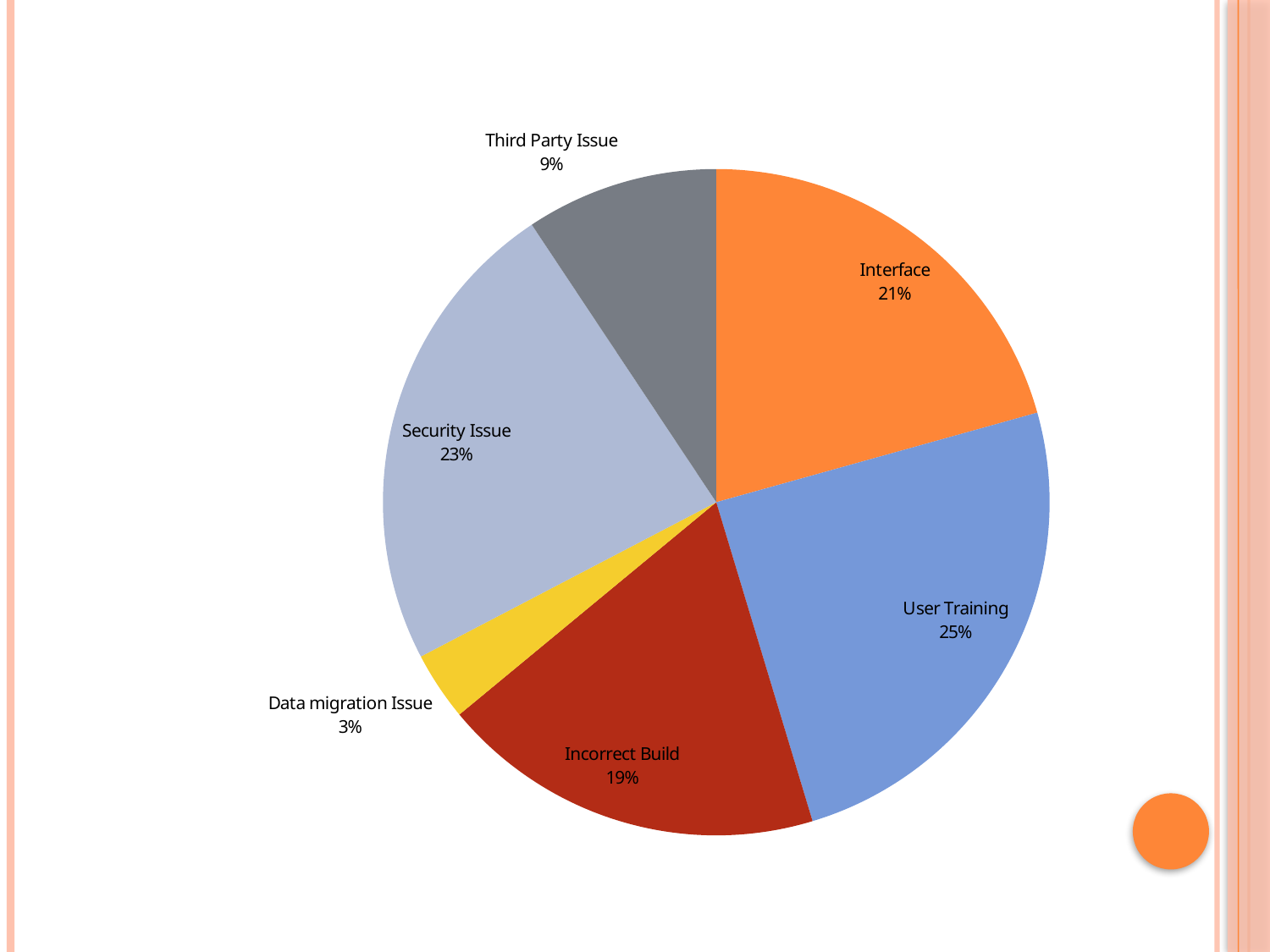
What percentage is shown for Security Issue? 23% Which category has the largest slice of the pie? User Training What share of the pie does User Training represent? 25% How many categories are shown in the pie chart? 6 Which category has the smallest slice of the pie? Data migration Issue What percentage is shown for Incorrect Build? 19% What colour is the Data migration Issue slice? Yellow What is the difference in percentage points between Security Issue and Third Party Issue? 14 What kind of chart is shown on the slide? Pie chart Which is larger, the share for Interface or the share for Incorrect Build? Interface What percentage is shown for Third Party Issue? 9% What percentage is shown for Interface? 21%